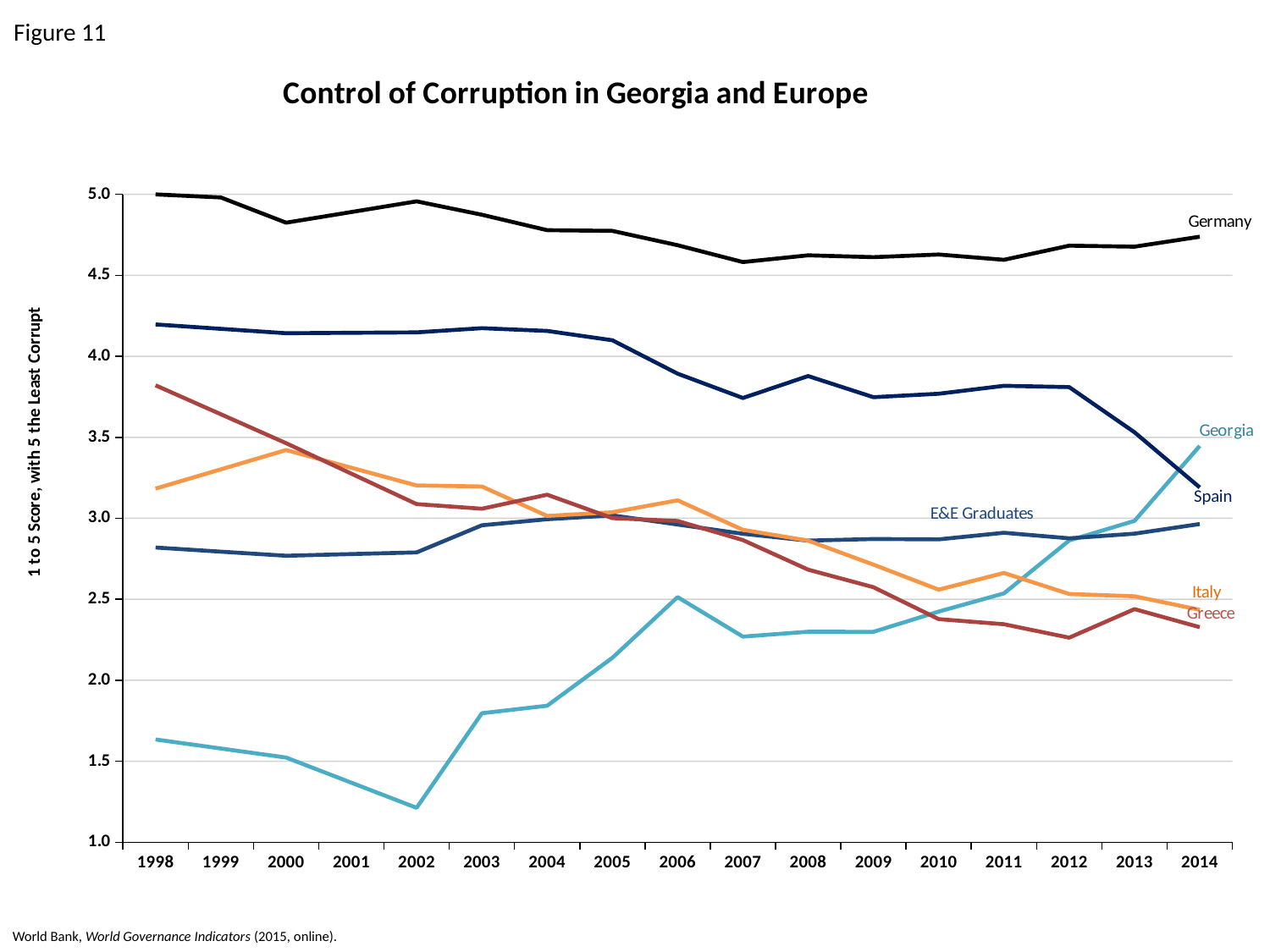
What is the title of the chart? Control of Corruption in Georgia and Europe Does the Georgia line generally rise or fall from 1998 to 2014? rise Which series has the highest value in 1998? Germany What kind of chart is shown on the slide? line chart Is the value for Spain in 2014 greater or less than 3.5? less In 1998, which is higher: Greece or Italy? Greece Which series has the lowest value in 1998? Georgia How many years are shown along the x axis of the chart? 17 Is the value for Georgia in 2002 greater or less than 1.5? less How many series are labelled on the chart? 6 Does the Spain line generally rise or fall from 1998 to 2014? fall In 2014, which is higher: Georgia or Spain? Georgia